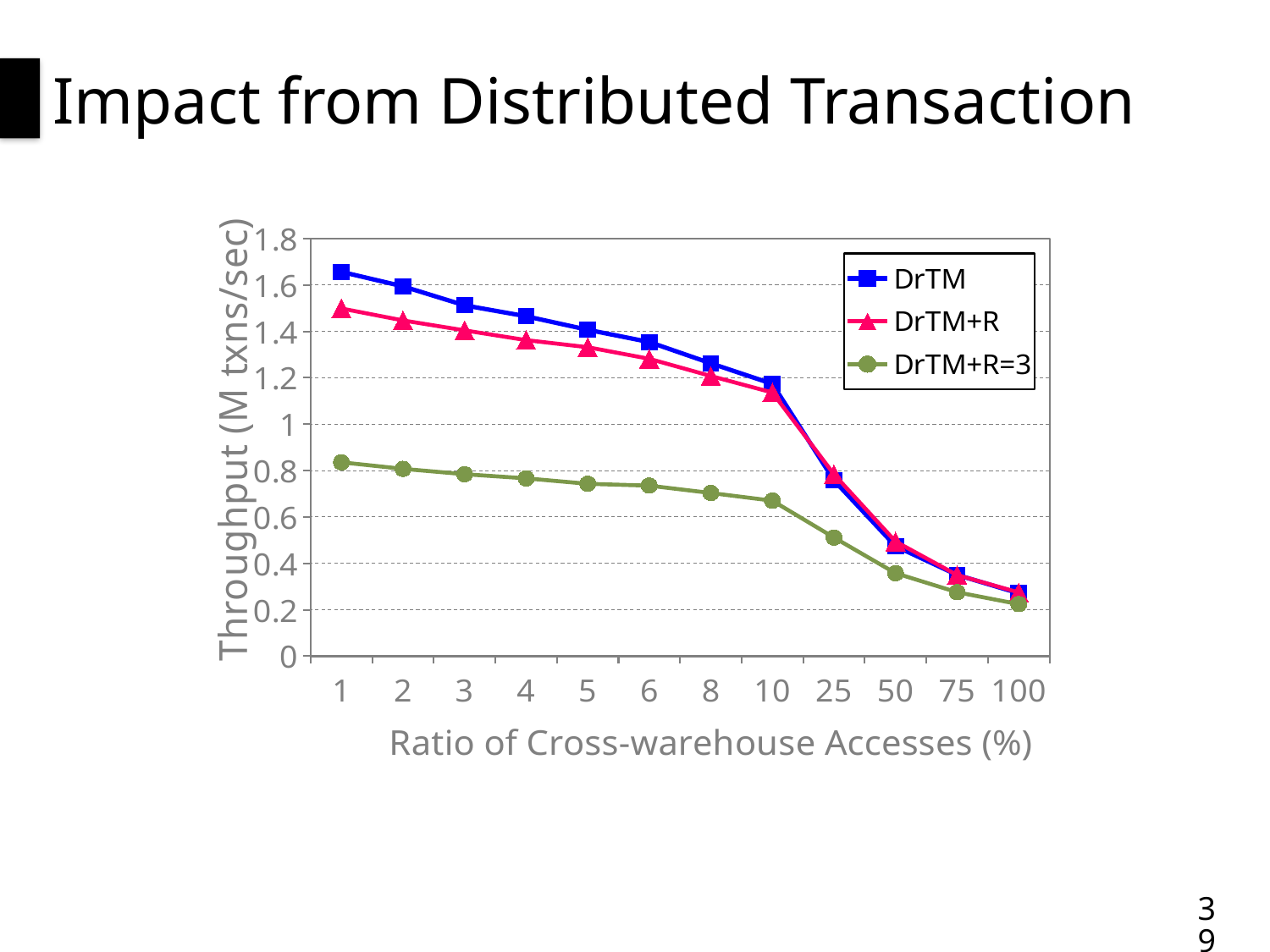
Is the throughput of DrTM at a ratio of 1% greater or less than 1.4? greater What is the label of the y axis? Throughput (M txns/sec) Which series has the highest throughput at a ratio of 1%? DrTM How many series does the legend list? 3 At a ratio of 1%, which has higher throughput, DrTM or DrTM+R=3? DrTM Which series has the lowest throughput at a ratio of 5%? DrTM+R=3 Does the throughput of DrTM rise or fall as the ratio of cross-warehouse accesses increases? fall What kind of chart is shown on the slide? line chart How many x-axis categories (ratio values) are plotted? 12 Is the throughput of DrTM+R at a ratio of 10% greater or less than 1? greater Is the throughput of DrTM+R=3 at a ratio of 1% greater or less than 1? less